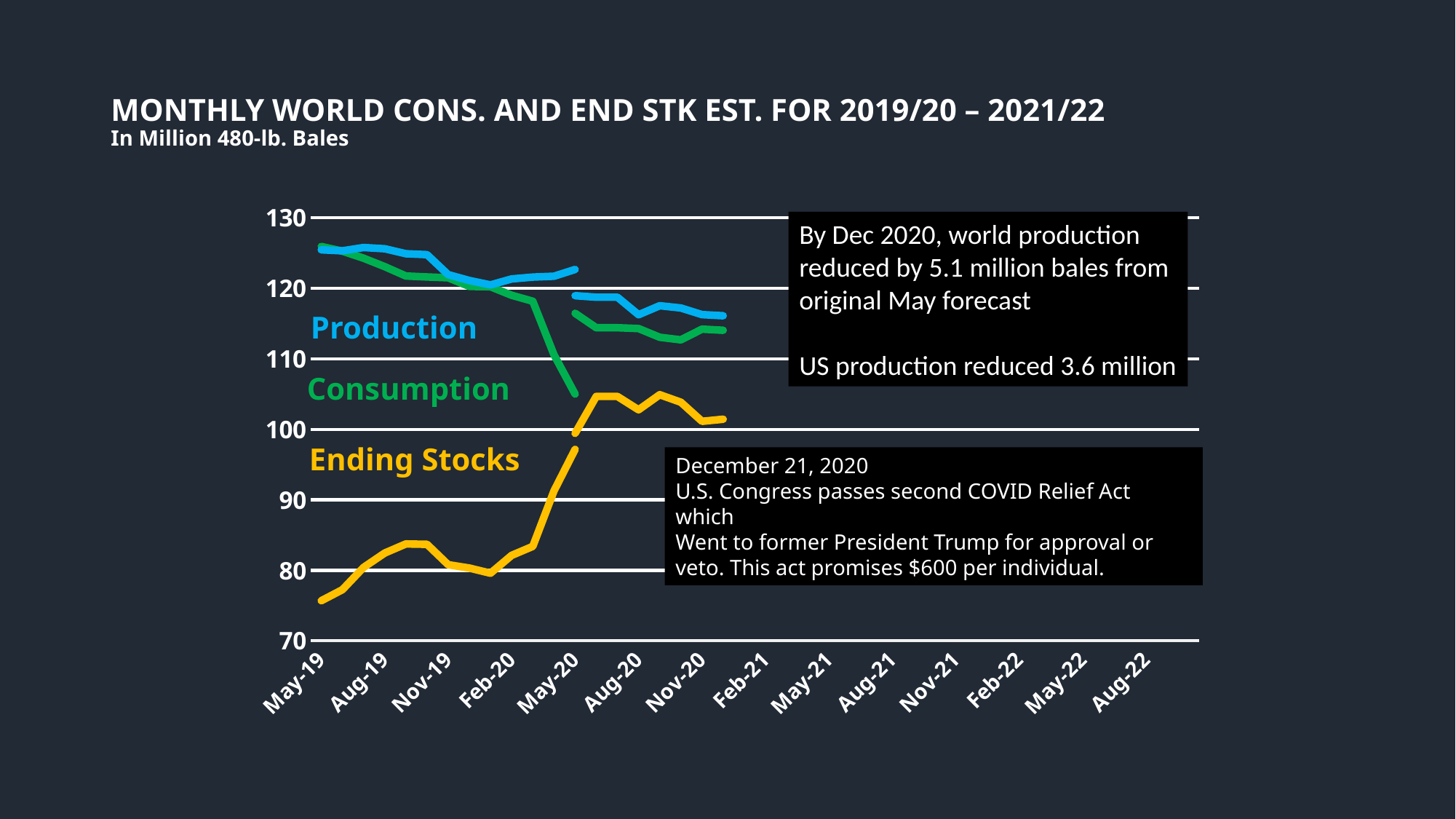
At May-20, which is higher: Production or Ending Stocks? Production Does the Ending Stocks line rise or fall from May-19 to May-20? rise Is the value for Ending Stocks at May-19 greater or less than 80? less What unit of measurement is stated under the chart title? In Million 480-lb. Bales Is the value for Consumption at May-20 greater or less than 100? greater What kind of chart is shown on the slide? line chart Is the value for Production at Nov-20 greater or less than 120? less What colour is the Ending Stocks line? yellow Does the Consumption line rise or fall from May-19 to May-20? fall How many data series are plotted on the chart? 3 How many month labels are shown along the x axis? 14